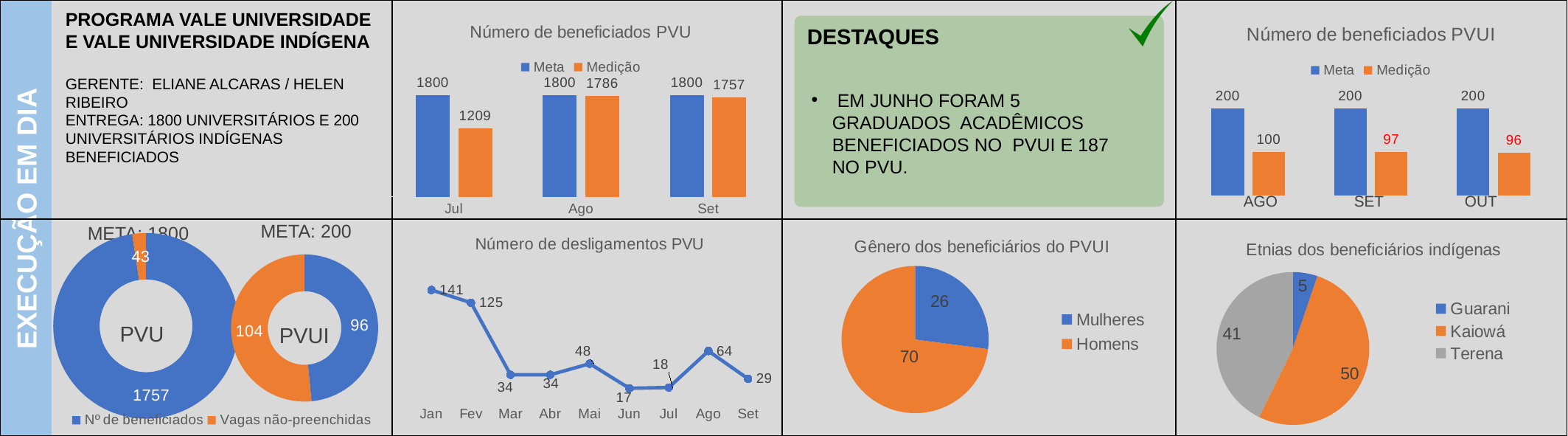
In the PVUI donut chart on the bottom left, what is the value for Vagas não-preenchidas? 104 In the 'Número de desligamentos PVU' chart, what is the value for Ago? 64 In the 'Número de desligamentos PVU' chart, which month has the lowest value? Jun In the 'Número de beneficiados PVU' chart, what is the difference between the Meta and Medição values for Set? 43 How many months are plotted in the 'Número de desligamentos PVU' chart? 9 How many series does the legend of the 'Número de beneficiados PVUI' chart list? 2 What kind of chart is 'Número de desligamentos PVU'? line chart In the 'Número de beneficiados PVUI' chart, which month has the highest Medição value? AGO In the 'Número de beneficiados PVU' chart, what is the Medição value for Jul? 1209 In the 'Número de beneficiados PVUI' chart, what is the Medição value for OUT? 96 In the 'Gênero dos beneficiários do PVUI' chart, what is the value for Homens? 70 In the 'Etnias dos beneficiários indígenas' chart, which ethnicity has the largest slice? Kaiowá